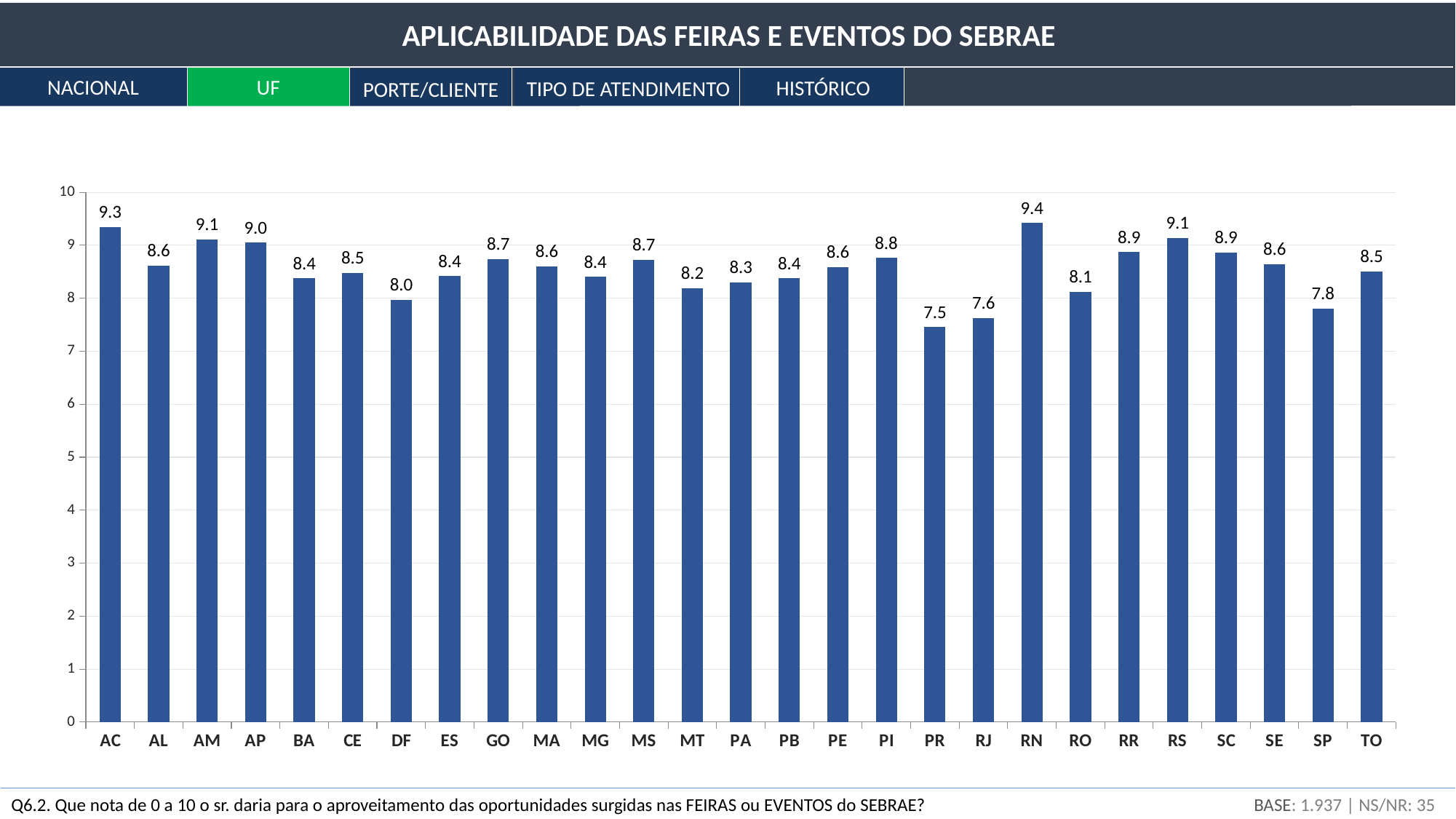
What is the difference between the values for RN and SP? 1.6 Which state has the highest value? RN How many states (UF) are shown on the x axis? 27 What is the value for RN? 9.4 What is the difference between the values for AC and PR? 1.8 Which is larger, the value for AM or the value for RJ? AM What is the value for DF? 8.0 Is the value for PR greater or less than 8? less What is the value for SP? 7.8 Which state has the lowest value? PR What is the title of the slide? APLICABILIDADE DAS FEIRAS E EVENTOS DO SEBRAE What kind of chart is shown on the slide? bar chart